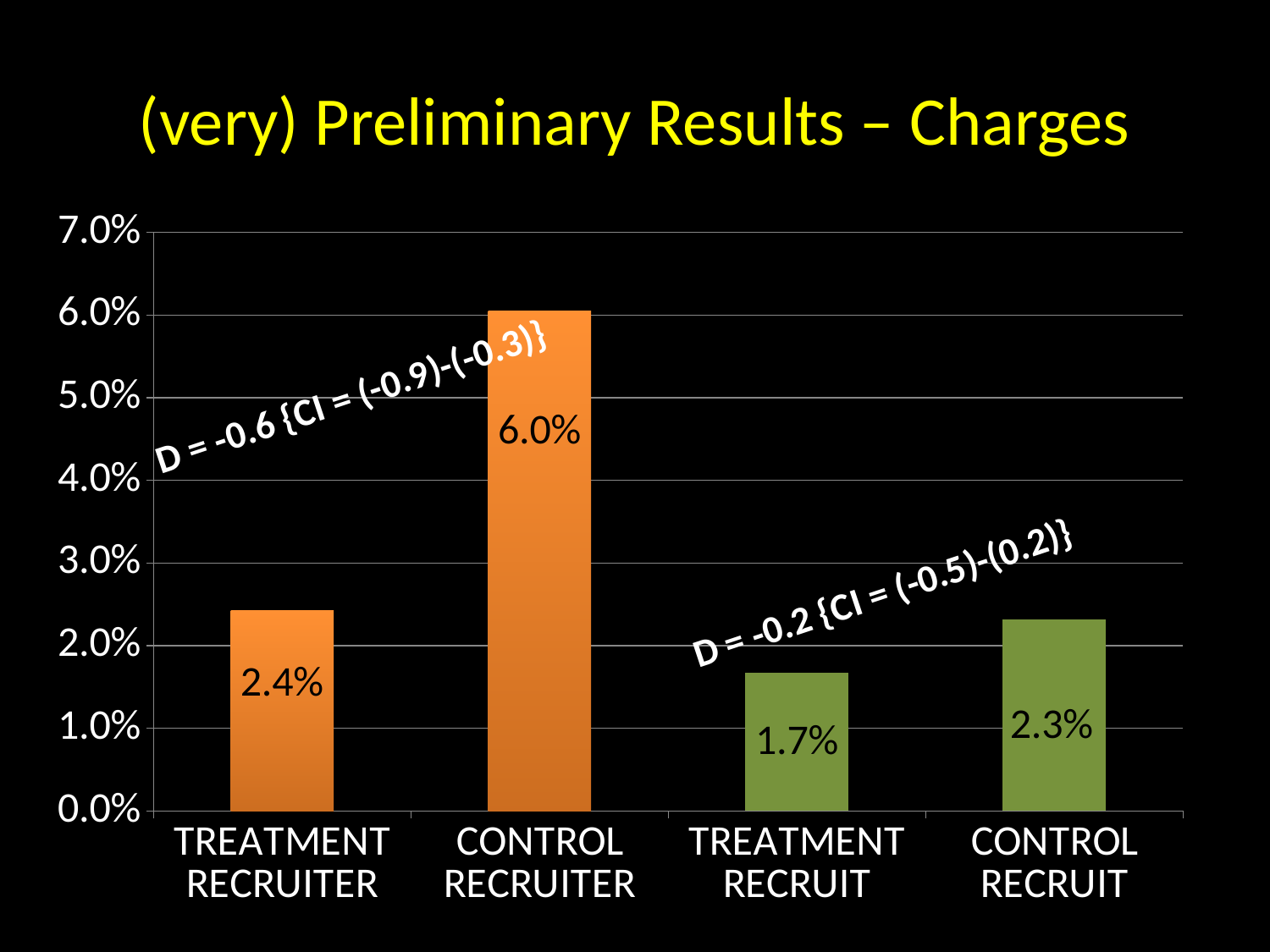
How many categories are shown on the x axis? 4 What is the title of the slide? (very) Preliminary Results – Charges What is the value for CONTROL RECRUITER? 6.0% Which category has the lowest value? TREATMENT RECRUIT Is the value for CONTROL RECRUITER greater or less than 5.0%? greater Which is larger, the value for TREATMENT RECRUITER or the value for TREATMENT RECRUIT? TREATMENT RECRUITER What is the difference between the values for CONTROL RECRUITER and TREATMENT RECRUITER? 3.6% What is the value for CONTROL RECRUIT? 2.3% What is the value for TREATMENT RECRUITER? 2.4% What kind of chart is shown on the slide? bar chart Which category has the highest value? CONTROL RECRUITER What is the value for TREATMENT RECRUIT? 1.7%